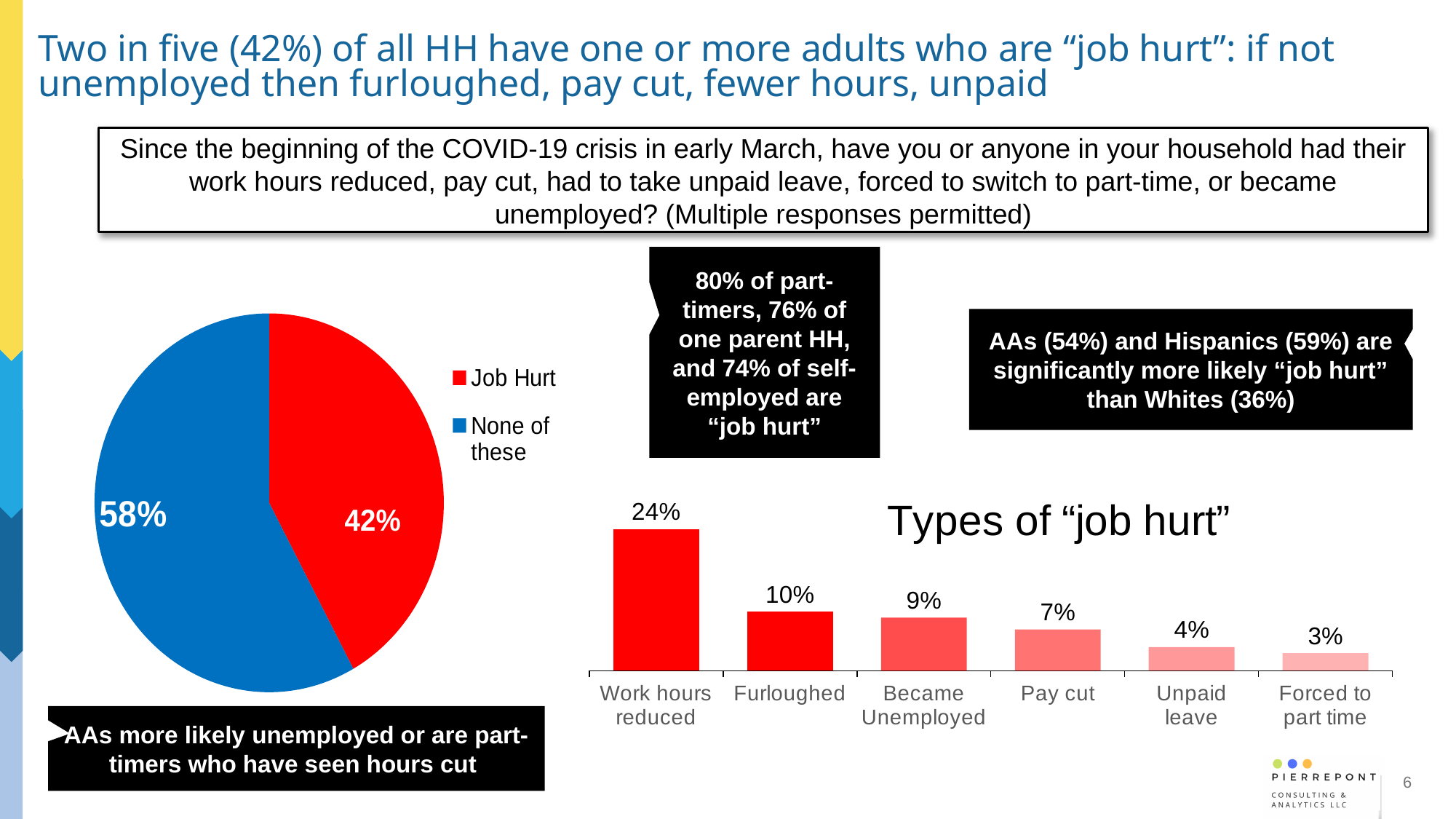
In the "Types of "job hurt"" chart, which category has the lowest value? Forced to part time In the pie chart on the left, what colour is the "Job Hurt" slice? Red In the "Types of "job hurt"" chart, how many categories are shown? 6 In the "Types of "job hurt"" chart, which category has the highest value? Work hours reduced In the "Types of "job hurt"" chart, what is the value for "Work hours reduced"? 24% What kind of chart is the "Types of "job hurt"" chart? Bar chart In the pie chart on the left, what share is labelled "None of these"? 58% In the pie chart on the left, how many entries does the legend list? 2 In the pie chart on the left, what share is labelled "Job Hurt"? 42% In the "Types of "job hurt"" chart, what is the difference between "Work hours reduced" and "Furloughed"? 14% In the "Types of "job hurt"" chart, what is the value for "Pay cut"? 7% In the pie chart on the left, which slice is larger, "Job Hurt" or "None of these"? None of these